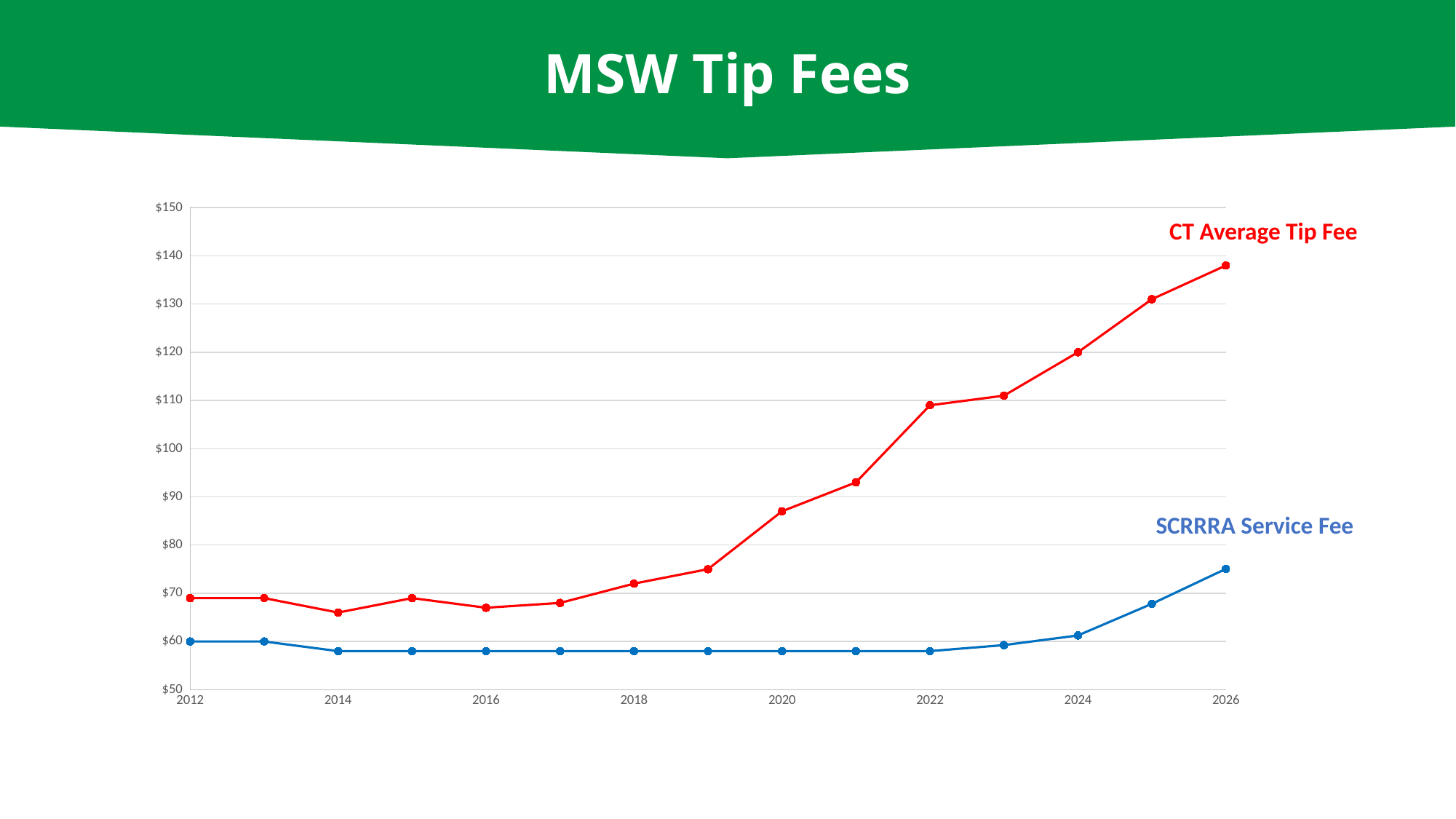
Is the CT Average Tip Fee value for 2022 greater or less than $100? greater Is the SCRRRA Service Fee value for 2020 greater or less than $60? less In which year is the CT Average Tip Fee at its highest? 2026 What colour is the CT Average Tip Fee line? red Is the CT Average Tip Fee value for 2026 greater or less than $130? greater In 2026, which series has the higher value, CT Average Tip Fee or SCRRRA Service Fee? CT Average Tip Fee Does the CT Average Tip Fee rise or fall from 2018 to 2026? rise How many years are plotted along the x axis of the chart? 15 What kind of chart is shown on the slide? line chart How many series are plotted on the chart? 2